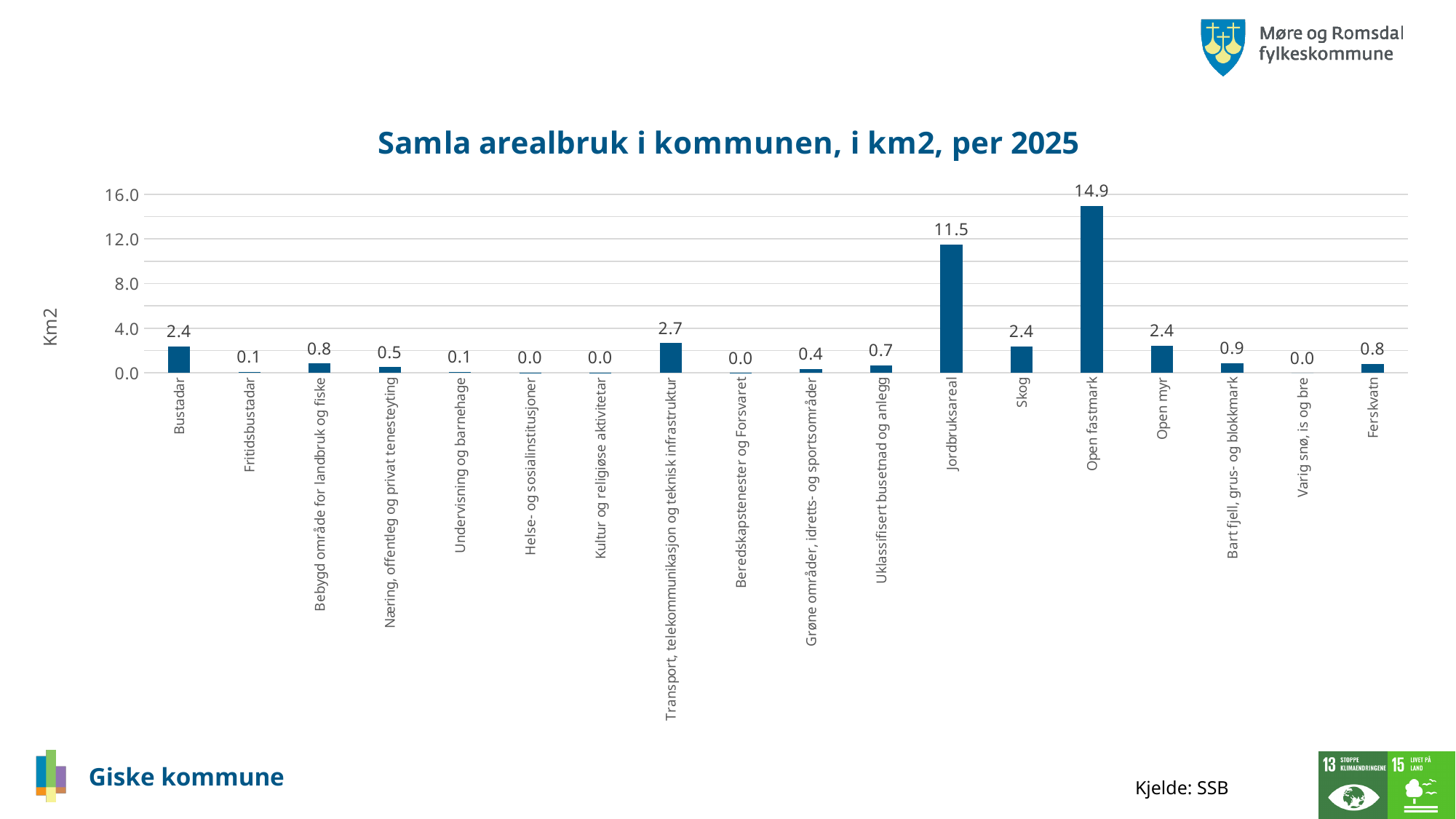
Is the value for Open fastmark greater or less than 12.0? greater What is the title of the chart? Samla arealbruk i kommunen, i km2, per 2025 How many categories are shown on the x axis? 18 What is the value for Ferskvatn? 0.8 What is the value for Transport, telekommunikasjon og teknisk infrastruktur? 2.7 What is the value for Jordbruksareal? 11.5 Which is larger, the value for Jordbruksareal or the value for Skog? Jordbruksareal What kind of chart is shown on the slide? bar chart What is the value for Bustadar? 2.4 What is the difference between the values for Open fastmark and Jordbruksareal? 3.4 Which category has the highest value? Open fastmark What is the value for Open fastmark? 14.9